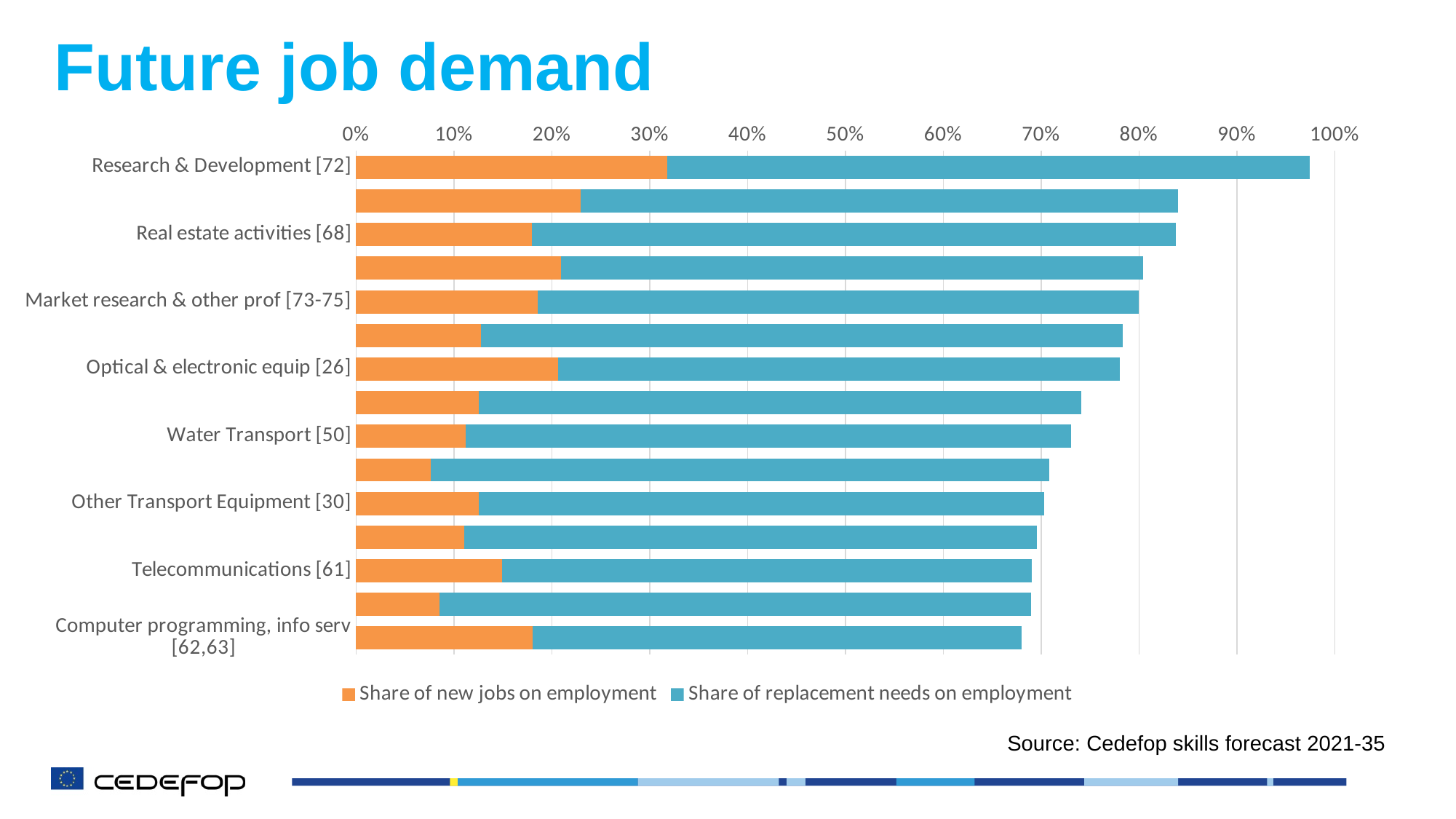
Is the total bar for Real estate activities [68] greater or less than 80%? greater How many series does the legend list? 2 What kind of chart is shown on the slide? Stacked bar chart Which has the longer total bar, Real estate activities [68] or Water Transport [50]? Real estate activities [68] Do the total bar lengths increase or decrease going from the top of the chart to the bottom? decrease Is the total bar for Computer programming, info serv [62,63] greater or less than 70%? less What are the two series named in the legend? Share of new jobs on employment; Share of replacement needs on employment How many bars are plotted in the chart? 15 Is the total bar for Research & Development [72] greater or less than 90%? greater Among the labelled sectors, which has the longest total bar? Research & Development [72] Which colour represents the share of new jobs on employment? Orange